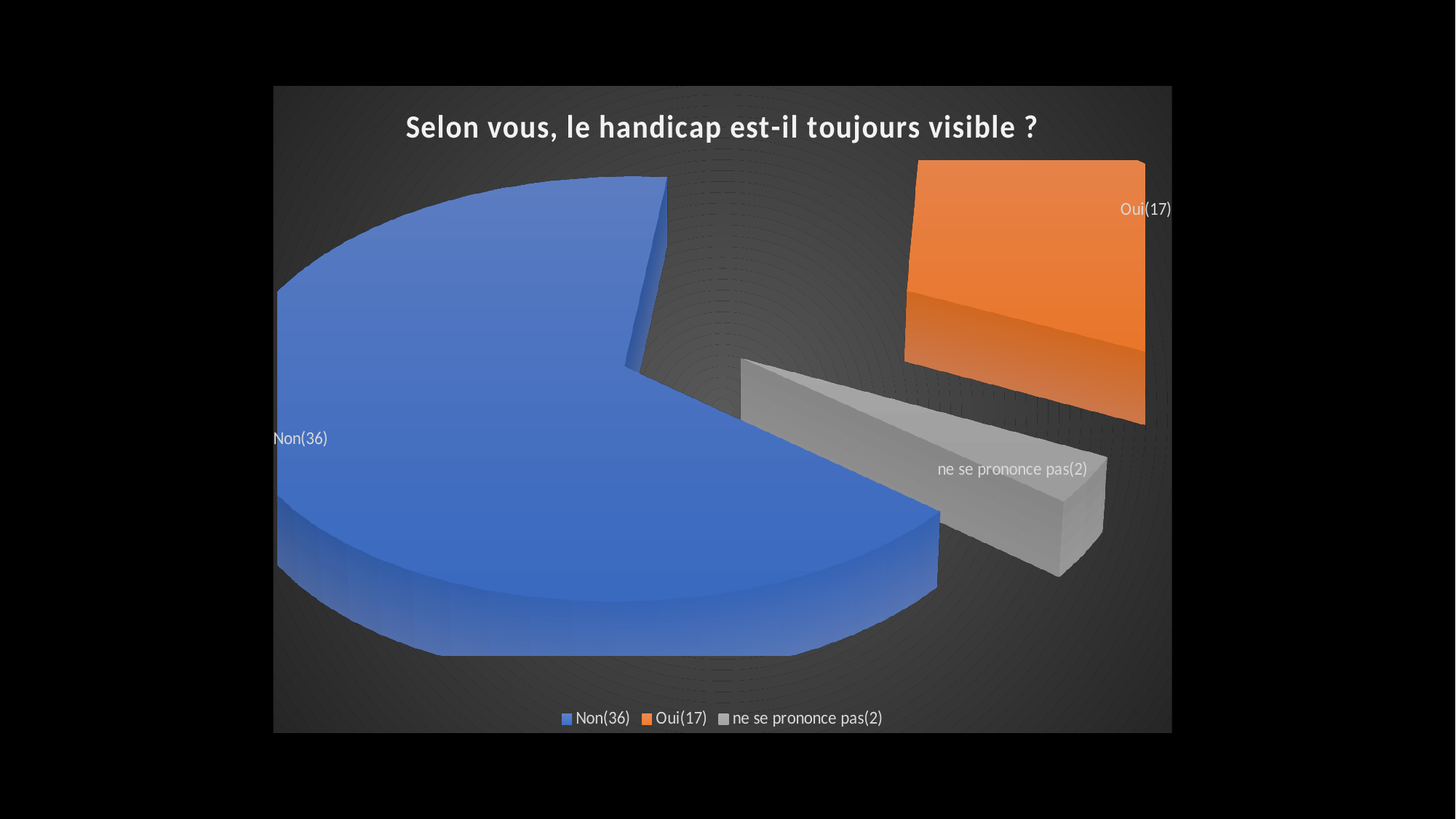
What type of chart is shown on the slide? Pie chart What is the value shown for "ne se prononce pas"? 2 Which category has the largest slice of the pie chart? Non Which is larger, the value for "Oui" or the value for "ne se prononce pas"? Oui What is the value shown for "Oui" in the pie chart? 17 What is the difference between the values for "Non" and "Oui"? 19 What colour is the "Oui" slice in the pie chart? Orange How many categories are shown in the pie chart? 3 What is the title of the chart? Selon vous, le handicap est-il toujours visible ? How many respondents answered "Non" according to the pie chart? 36 Which category has the smallest slice of the pie chart? ne se prononce pas How much larger is the value for "Oui" than the value for "ne se prononce pas"? 15